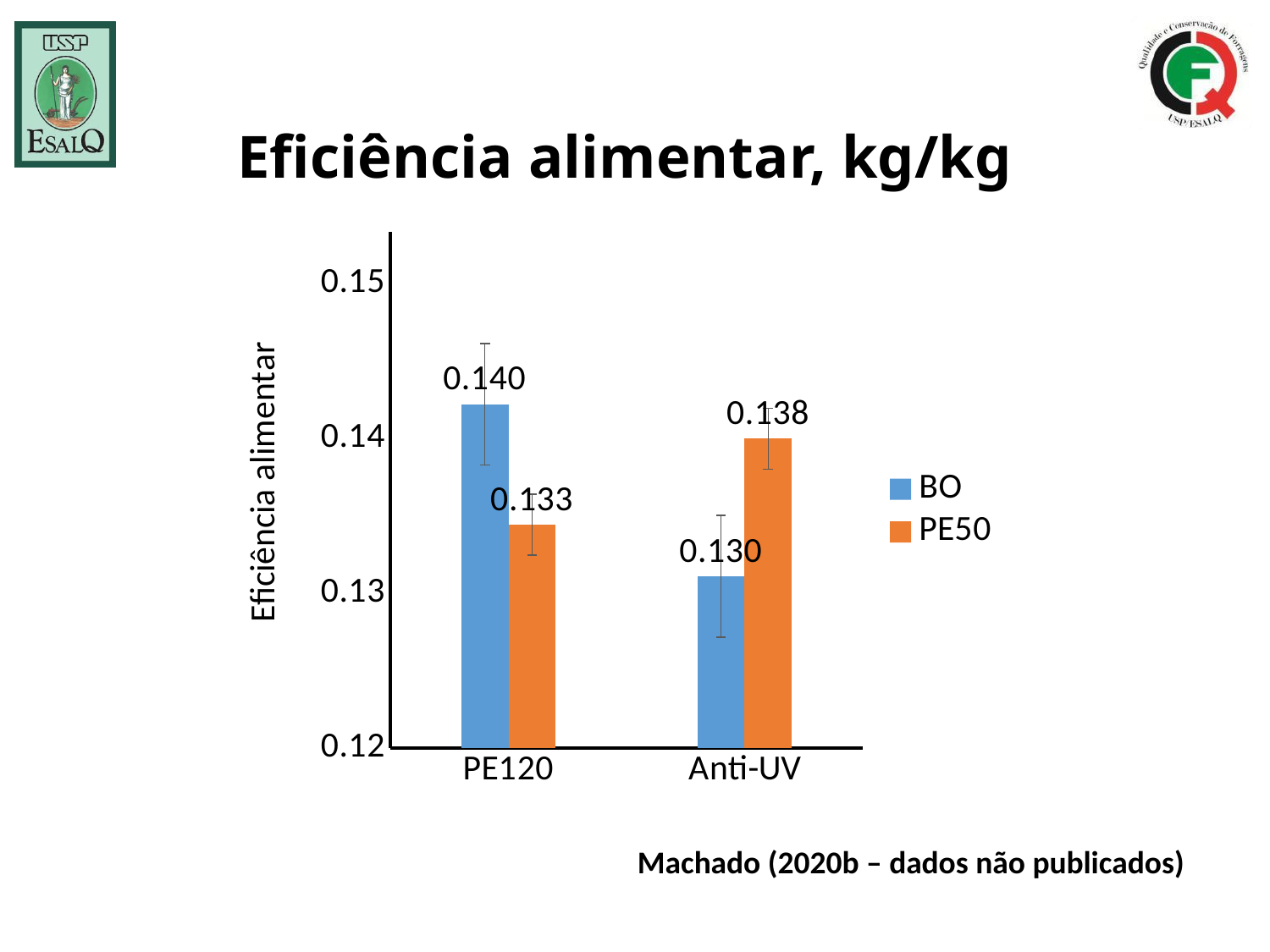
How many series does the legend list? 2 Which bar has the lowest value on the chart? BO in Anti-UV What is the value for PE50 in the PE120 category? 0.133 What is the value for BO in the PE120 category? 0.140 In the Anti-UV category, which series has the larger value, BO or PE50? PE50 Which bar has the highest value on the chart? BO in PE120 What is the value for PE50 in the Anti-UV category? 0.138 What is the difference between the PE50 and BO values in the Anti-UV category? 0.008 What kind of chart is shown on the slide? Bar chart What is the difference between the BO and PE50 values in the PE120 category? 0.007 How many categories are shown on the x axis? 2 What is the value for BO in the Anti-UV category? 0.130